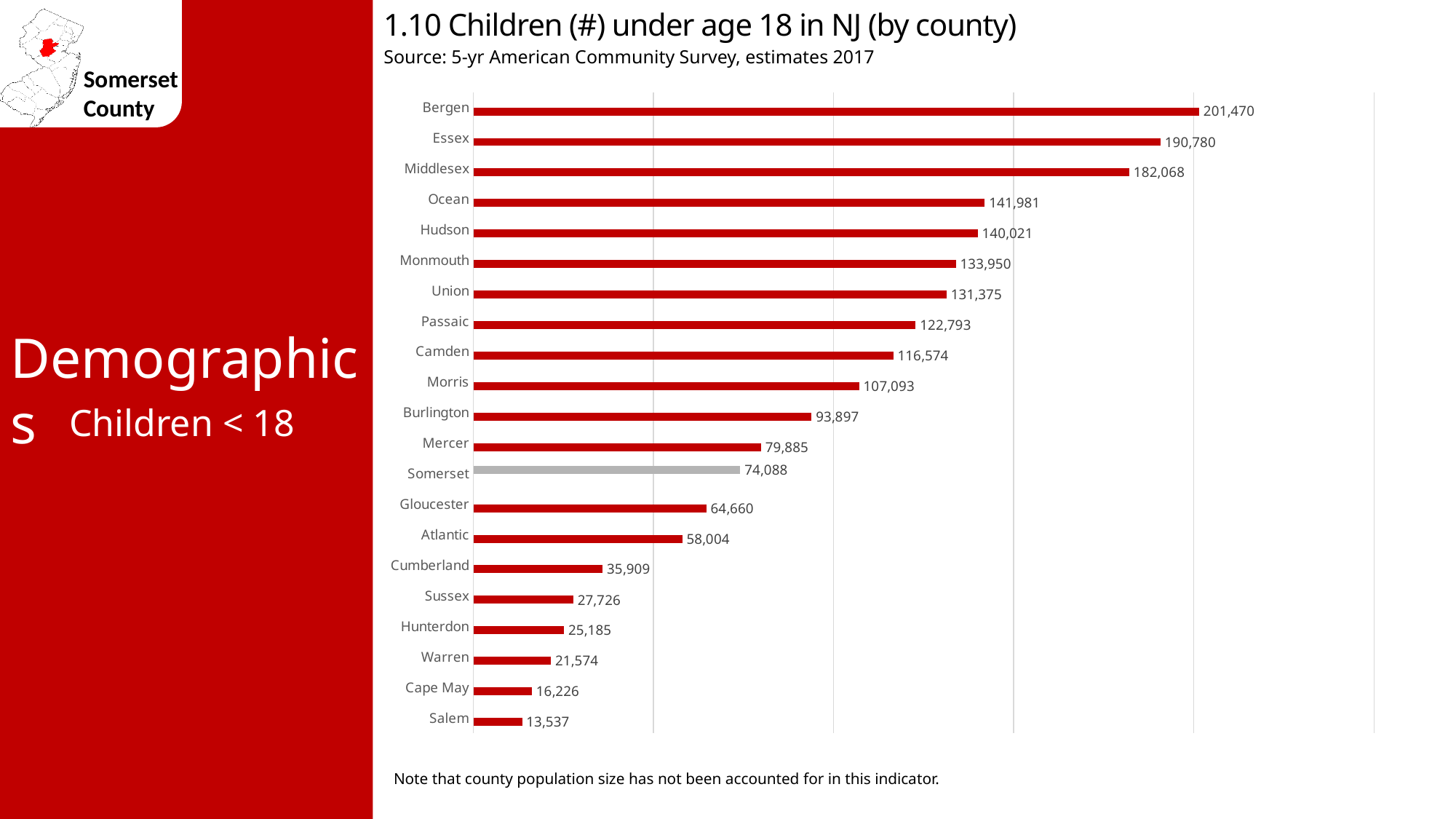
What type of chart is used on this slide? Bar chart How many counties are shown in the chart? 21 What is the difference between the values for Bergen and Essex? 10,690 Which county has the lowest number of children under age 18? Salem What is the value shown for Salem County? 13,537 Which county has the highest number of children under age 18? Bergen Which county has more children under 18, Mercer or Burlington? Burlington What is the difference between the values for Somerset and Gloucester? 9,428 What is the number of children under age 18 in Bergen County? 201,470 What is the number of children under age 18 in Somerset County? 74,088 Which county's bar is shown in grey rather than red? Somerset Which county has more children under 18, Sussex or Hunterdon? Sussex